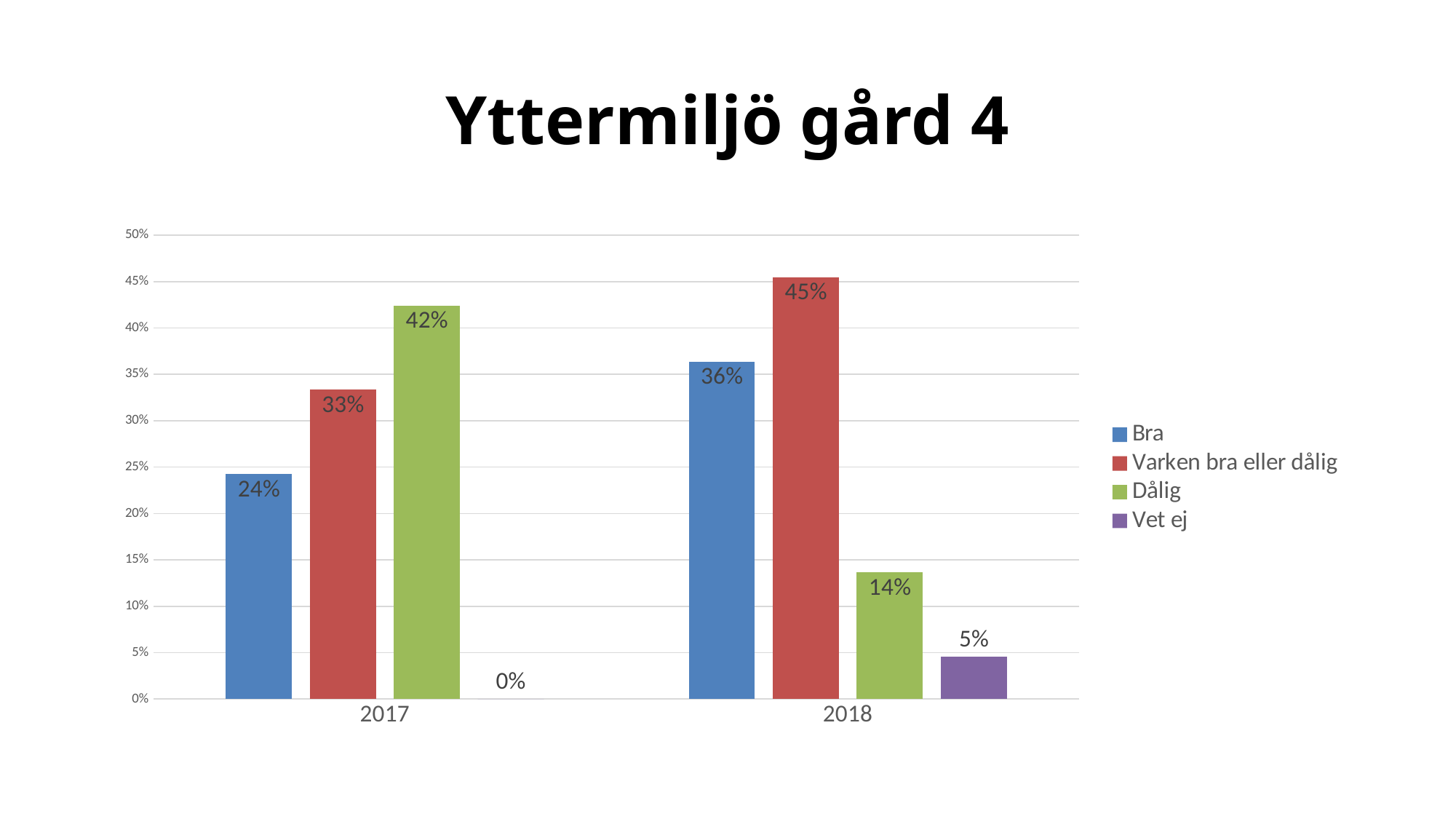
What is the value for Varken bra eller dålig in 2018? 45% Which series has the lowest value in 2017? Vet ej How many series does the legend list? 4 Which series has the highest value in 2018? Varken bra eller dålig How many categories are shown on the x axis? 2 What is the title of the chart? Yttermiljö gård 4 What is the difference between the Dålig values for 2017 and 2018? 28% What is the value for Vet ej in 2018? 5% What is the value for Dålig in 2017? 42% What is the value for Bra in 2017? 24% What kind of chart is shown? Bar chart Which is larger, Bra in 2017 or Bra in 2018? Bra in 2018